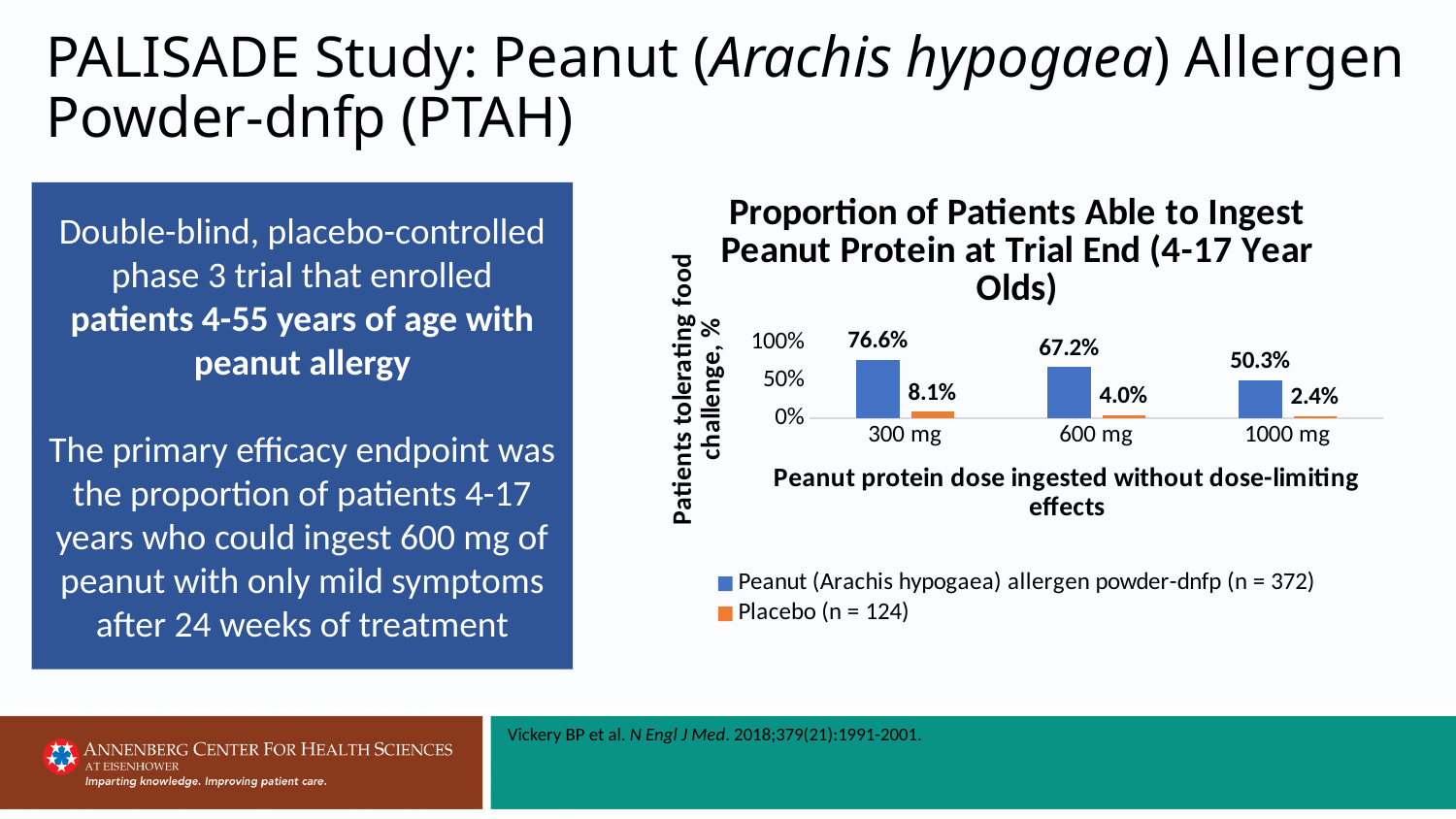
Do the Peanut allergen powder-dnfp values rise or fall as the dose increases from 300 mg to 1000 mg? Fall What percentage of patients in the Peanut allergen powder-dnfp group tolerated the 1000 mg dose? 50.3% At which dose was the proportion of Peanut allergen powder-dnfp patients tolerating the challenge highest? 300 mg How many series does the legend list? 2 What kind of chart is shown on the slide? Bar chart Which group had the larger proportion tolerating the 1000 mg dose, Peanut allergen powder-dnfp or Placebo? Peanut (Arachis hypogaea) allergen powder-dnfp What percentage of patients in the Placebo group tolerated the 300 mg dose? 8.1% Is the value for the Peanut allergen powder-dnfp group at 300 mg greater or less than 50%? greater What percentage of patients in the Peanut (Arachis hypogaea) allergen powder-dnfp group tolerated the 600 mg dose? 67.2% How many dose categories are shown on the x axis? 3 What is the difference between the Peanut allergen powder-dnfp and Placebo values at the 600 mg dose? 63.2% At which dose was the proportion of Placebo patients tolerating the challenge lowest? 1000 mg